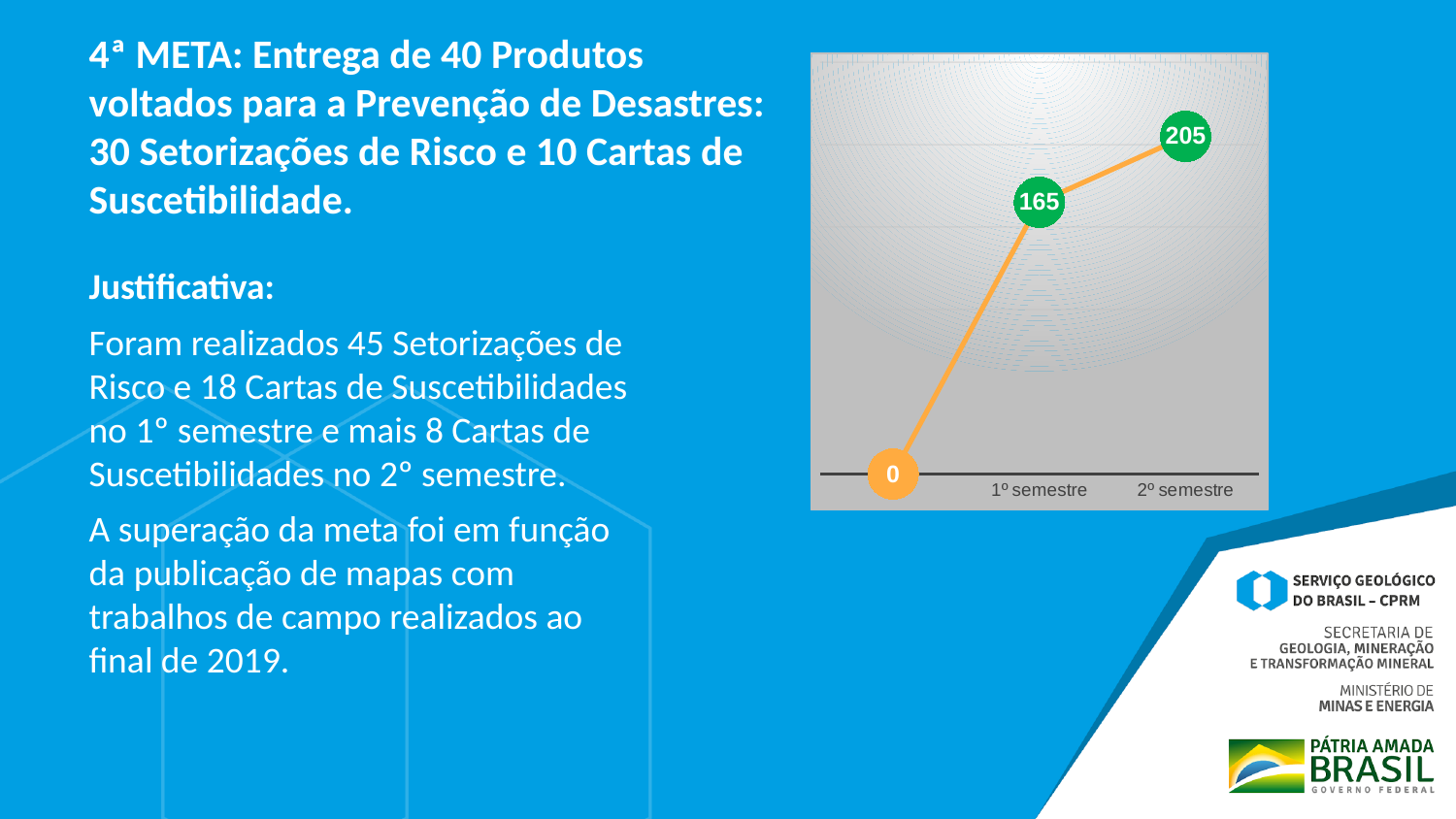
How many data points are plotted on the line? 3 How many category labels are shown on the x axis? 2 Is the value for 1º semestre larger or smaller than the value for 2º semestre? smaller What is the difference between the values for 2º semestre and 1º semestre? 40 Do the values rise or fall from left to right along the line? rise What is the value for 1º semestre? 165 What is the value of the first data point on the line, at the left end of the chart? 0 What is the value for 2º semestre? 205 Which labelled semester has the higher value? 2º semestre What colour are the data label markers for 165 and 205? green What colour is the line connecting the data points? orange What kind of chart is shown on the slide? line chart